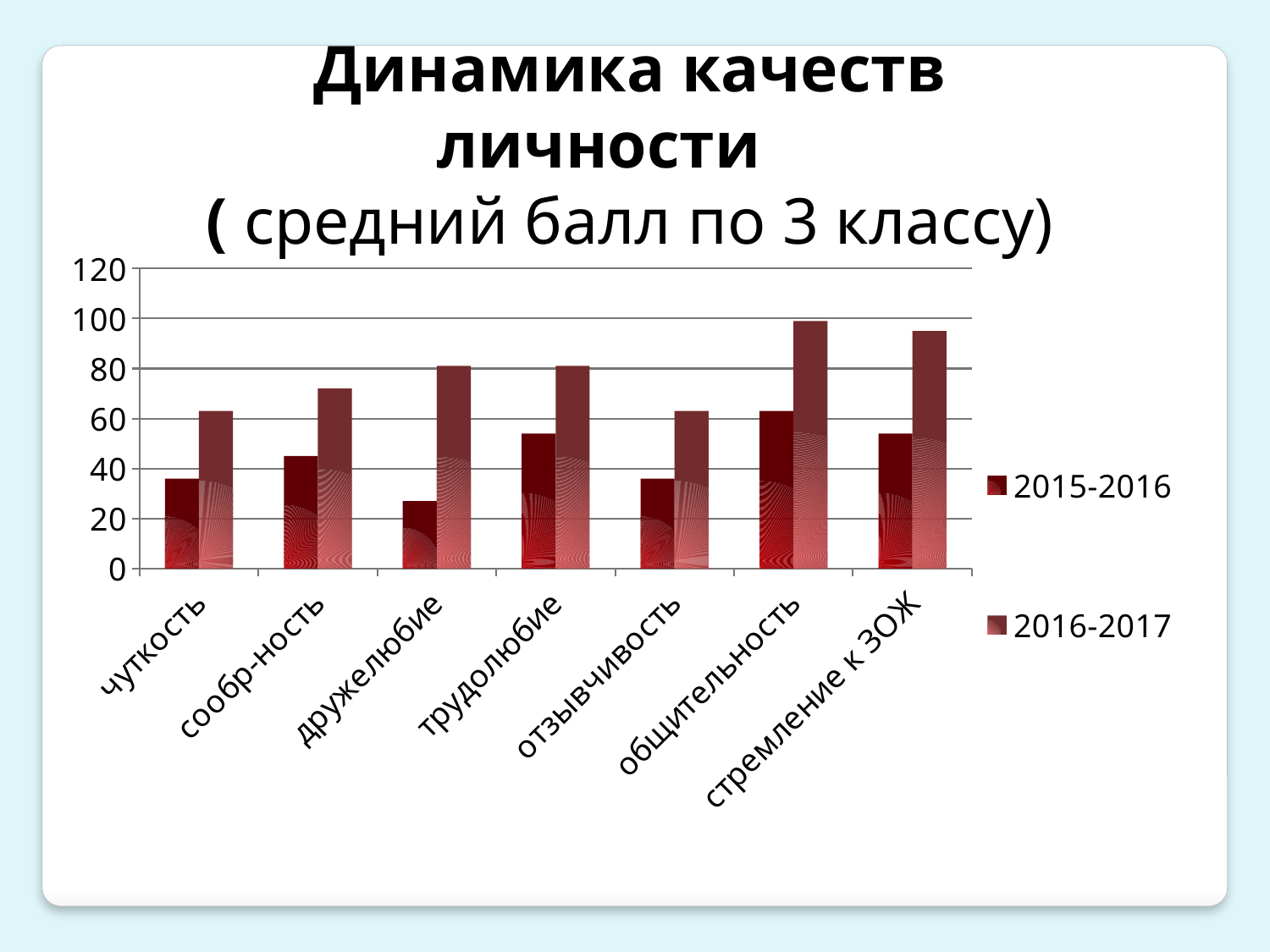
Is the 2015-2016 value for дружелюбие greater or less than 40? less How many series does the legend list? 2 What are the two series listed in the chart legend? 2015-2016 and 2016-2017 Is the 2015-2016 value for трудолюбие greater or less than 40? greater Which category has the highest value for the 2015-2016 series? общительность For дружелюбие, which series has the larger value, 2015-2016 or 2016-2017? 2016-2017 Which category has the highest value for the 2016-2017 series? общительность What kind of chart is shown on the slide? bar chart Which category has the lowest value for the 2015-2016 series? дружелюбие Is the 2016-2017 value for дружелюбие greater or less than 60? greater How many categories are shown on the x axis of the chart? 7